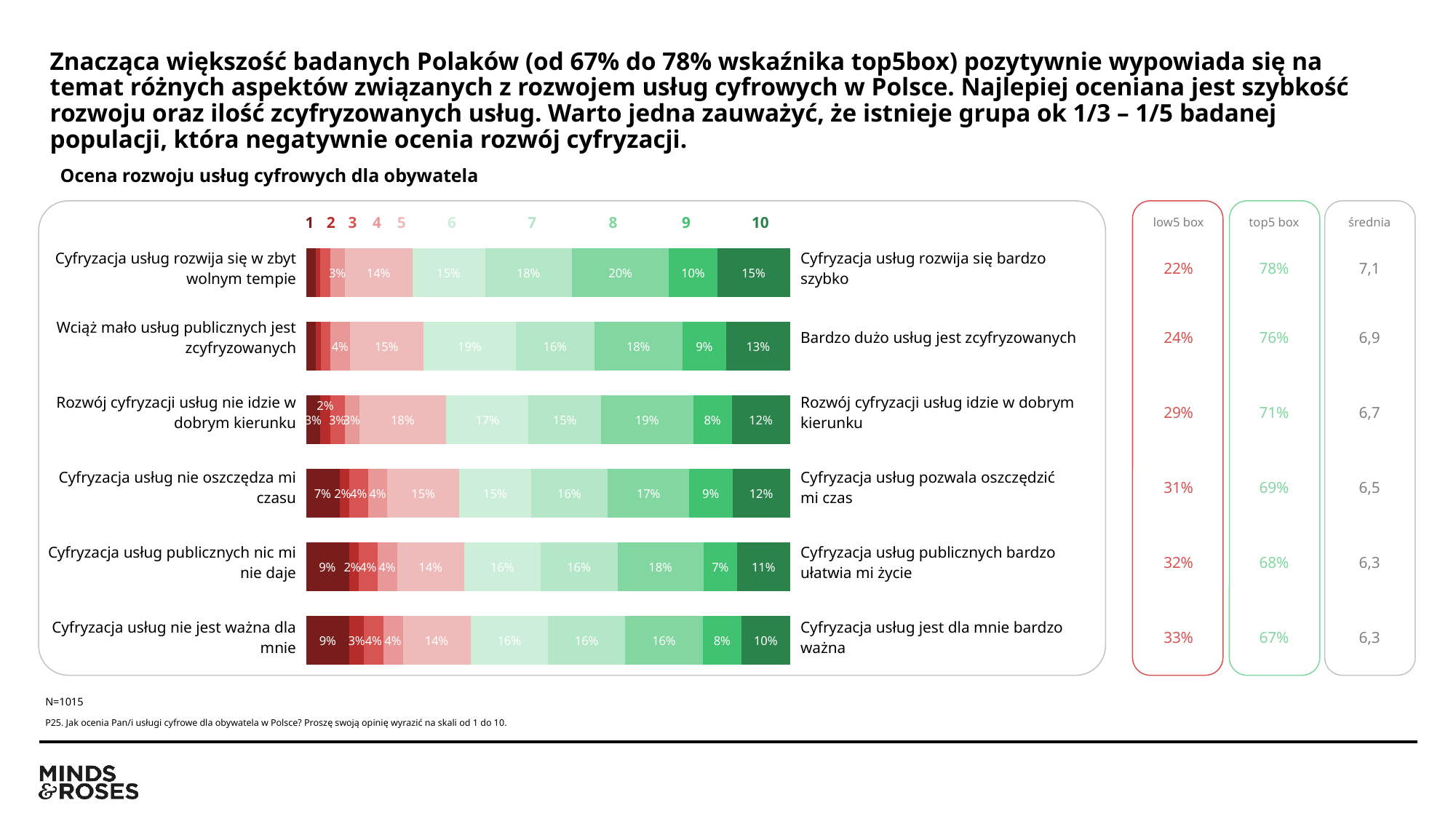
What is the difference in top5 box between 'Cyfryzacja usług rozwija się bardzo szybko' and 'Cyfryzacja usług jest dla mnie bardzo ważna'? 11 percentage points Which row has the highest top5 box value? Cyfryzacja usług rozwija się bardzo szybko How many statement pairs (rows) are shown in the chart? 6 Which row has the lowest top5 box value? Cyfryzacja usług jest dla mnie bardzo ważna What kind of chart is used to show the ratings on the 1–10 scale? stacked bar chart What is the średnia (mean) for the row 'Bardzo dużo usług jest zcyfryzowanych'? 6,9 What percentage gave a score of 10 in the row 'Cyfryzacja usług rozwija się bardzo szybko'? 15% What is the title of the chart? Ocena rozwoju usług cyfrowych dla obywatela Which row has the highest średnia (mean)? Cyfryzacja usług rozwija się bardzo szybko What is the low5 box value for the row 'Cyfryzacja usług jest dla mnie bardzo ważna'? 33% Which is larger: the low5 box for 'Cyfryzacja usług pozwala oszczędzić mi czas' or for 'Rozwój cyfryzacji usług idzie w dobrym kierunku'? Cyfryzacja usług pozwala oszczędzić mi czas What is the top5 box value for the row 'Cyfryzacja usług rozwija się bardzo szybko'? 78%